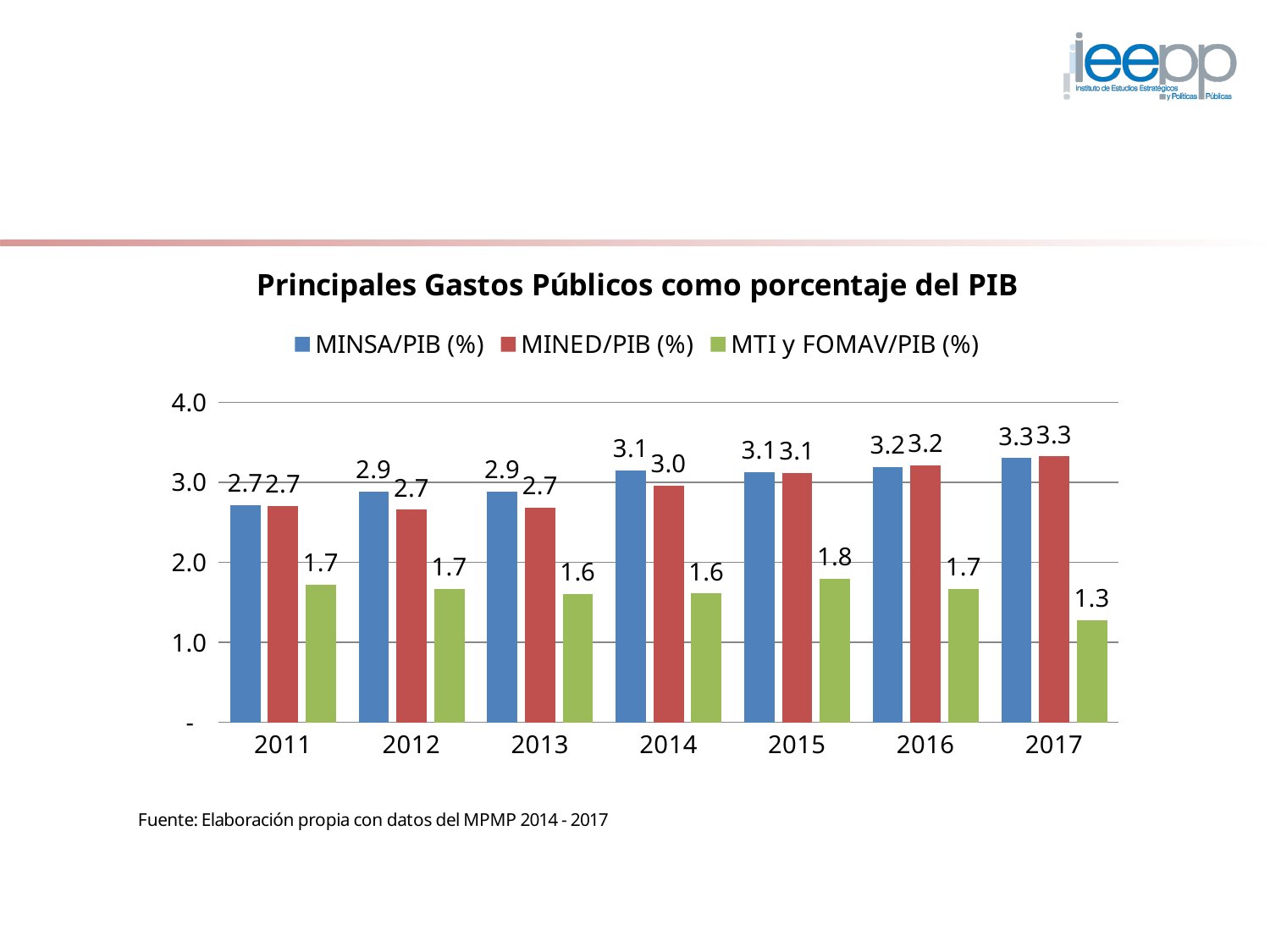
What is the value of MINSA/PIB (%) in 2014? 3.1 What is the value of MTI y FOMAV/PIB (%) in 2017? 1.3 In which year is MTI y FOMAV/PIB (%) highest? 2015 What kind of chart is shown on the slide? Bar chart How many years are shown on the x axis? 7 Is the value for MINED/PIB (%) in 2016 greater or less than 3.0? greater What is the difference between MINSA/PIB (%) and MTI y FOMAV/PIB (%) in 2017? 2.0 How many series does the legend list? 3 In which year is MTI y FOMAV/PIB (%) lowest? 2017 What is the value of MINED/PIB (%) in 2012? 2.7 Does MINSA/PIB (%) generally rise or fall from 2011 to 2017? Rise Which is larger in 2013, MINSA/PIB (%) or MINED/PIB (%)? MINSA/PIB (%)